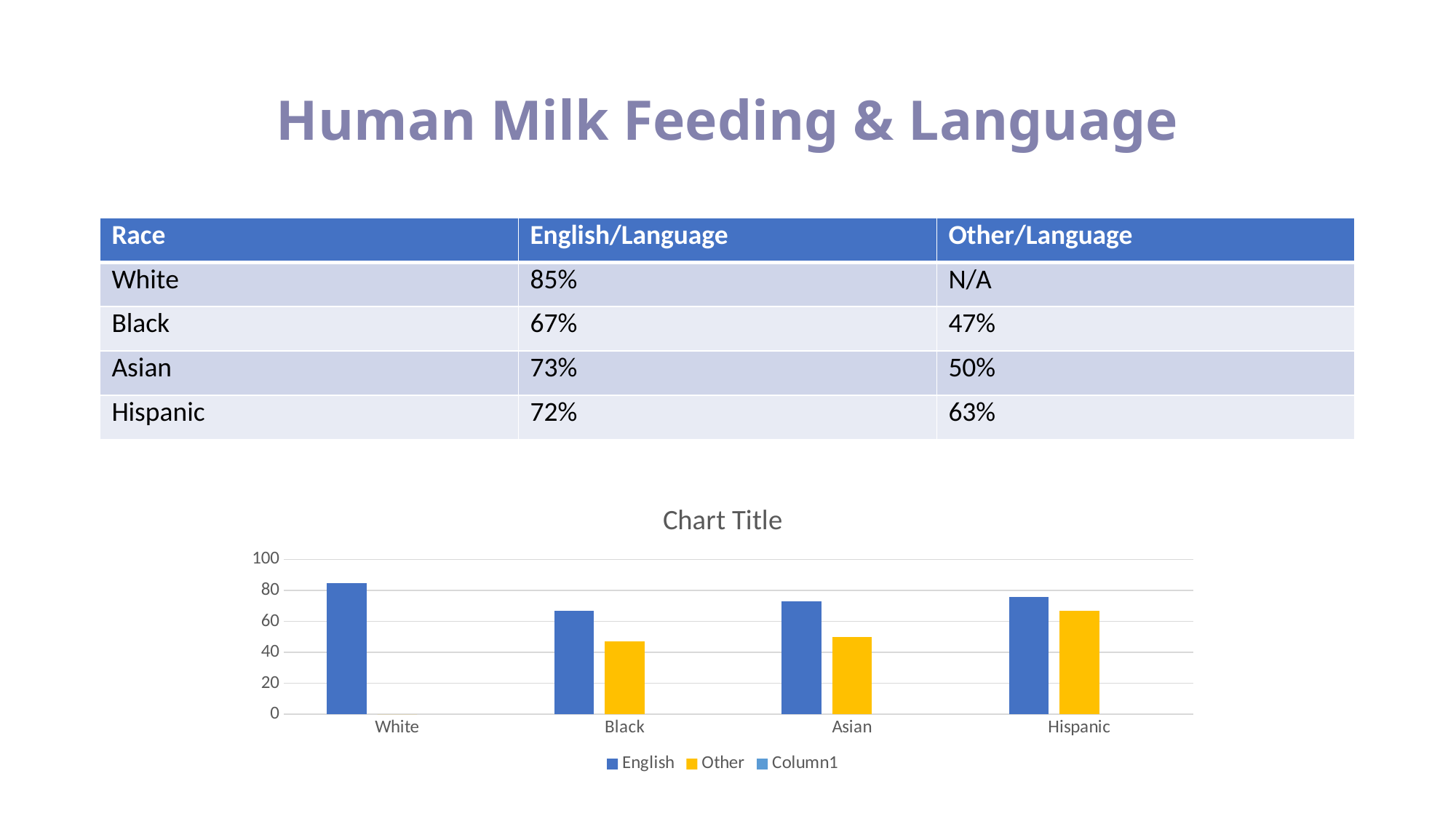
Is the English bar for Asian greater or less than 80? less What kind of chart is shown on the slide? bar chart Which category has the highest Other bar in the chart? Hispanic Which category has the highest English bar in the chart? White Which category has the lowest English bar in the chart? Black Is the Other bar for Black greater or less than 60? less Is the English bar for White greater or less than 80? greater Which is larger in the chart: the Other bar for Hispanic or the Other bar for Black? Hispanic Which category in the chart has no Other bar plotted? White How many race categories are shown on the x axis of the chart? 4 How many series does the chart legend list? 3 Which is larger in the chart: the English bar for White or the English bar for Black? White